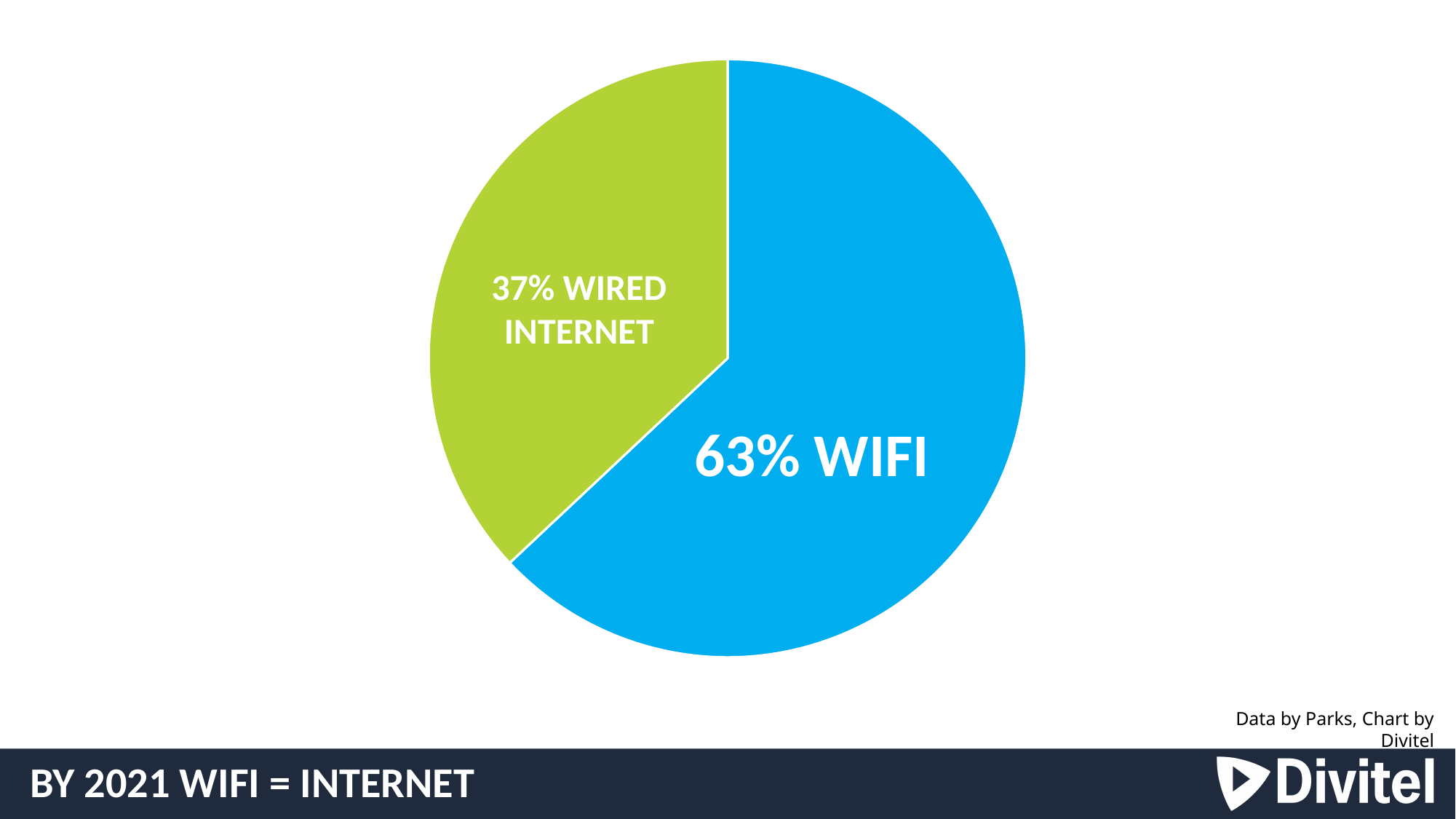
How many slices does the pie chart have? 2 What colour is the WIFI slice? Blue What do the two slices of the pie add up to? 100% Which slice of the pie is the smallest? WIRED INTERNET What kind of chart is shown on the slide? Pie chart What is the difference in percentage points between the WIFI slice and the WIRED INTERNET slice? 26 Is the WIFI share greater or less than 50%? greater Which is larger, the WIFI slice or the WIRED INTERNET slice? WIFI What colour is the WIRED INTERNET slice? Green What share of the pie does WIRED INTERNET represent? 37% What share of the pie does WIFI represent? 63% Which slice of the pie is the largest? WIFI